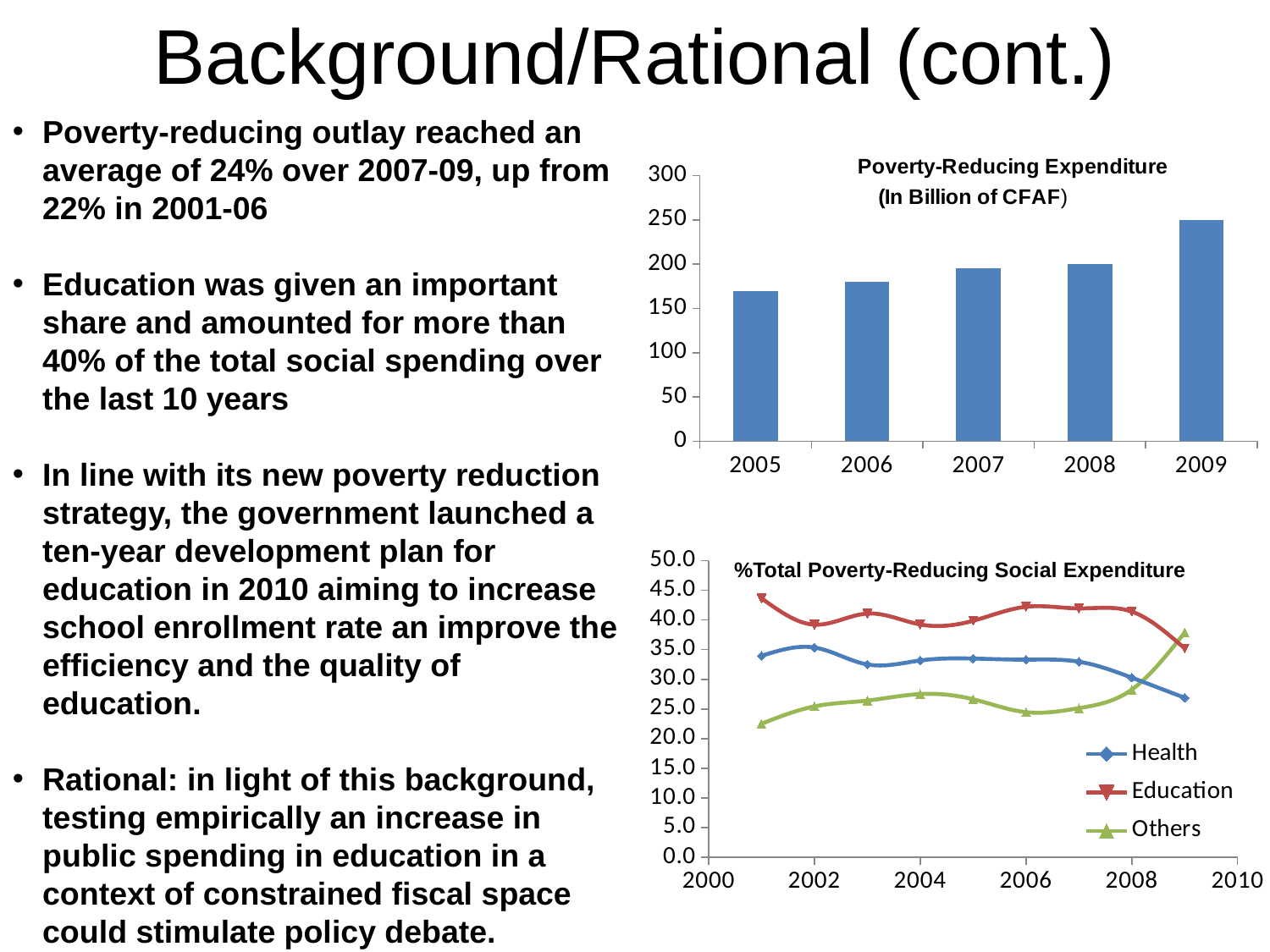
In the 'Poverty-Reducing Expenditure' chart, is the value for 2005 greater or less than 200? less In the 'Poverty-Reducing Expenditure' chart, which year has the lowest value? 2005 What type of chart is the 'Poverty-Reducing Expenditure' chart at the top right? bar chart How many series does the legend of the '%Total Poverty-Reducing Social Expenditure' chart list? 3 In the '%Total Poverty-Reducing Social Expenditure' chart, is the Others value for 2001 greater or less than 25.0? less What type of chart is the '%Total Poverty-Reducing Social Expenditure' chart at the bottom right? line chart In the 'Poverty-Reducing Expenditure' chart, is the value for 2009 greater or less than 200? greater In the 'Poverty-Reducing Expenditure' chart, do the values rise or fall from 2005 to 2009? rise In the '%Total Poverty-Reducing Social Expenditure' chart, which series is higher in 2005, Education or Health? Education How many years are shown in the 'Poverty-Reducing Expenditure' bar chart? 5 In the 'Poverty-Reducing Expenditure' chart, which year has the highest value? 2009